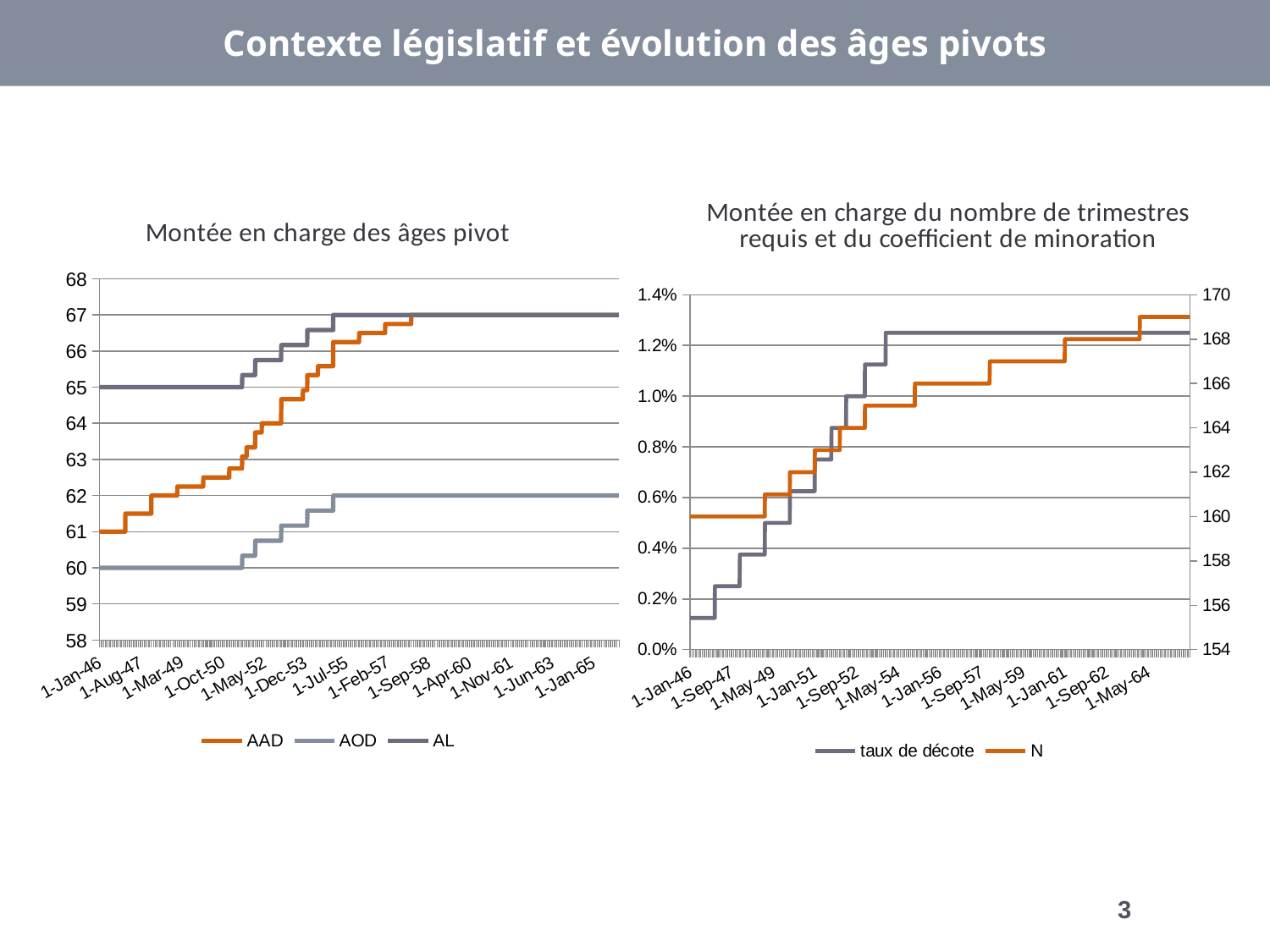
In the chart titled "Montée en charge des âges pivot", what is the value of AAD at 1-Jan-46? 61 In the chart titled "Montée en charge des âges pivot", how many series does the legend list? 3 In the chart titled "Montée en charge des âges pivot", what value does AOD reach at 1-Jan-65? 62 In the chart titled "Montée en charge du nombre de trimestres requis et du coefficient de minoration", is the value of taux de décote at 1-Jan-46 greater or less than 0.2%? less In the chart titled "Montée en charge des âges pivot", what is the value of AL at 1-Jan-46? 65 In the chart titled "Montée en charge des âges pivot", what kind of chart is shown? line chart In the chart titled "Montée en charge des âges pivot", what is the value of AOD at 1-Jan-46? 60 In the chart titled "Montée en charge du nombre de trimestres requis et du coefficient de minoration", what is the value of N at 1-Jan-46? 160 In the chart titled "Montée en charge du nombre de trimestres requis et du coefficient de minoration", how many series does the legend list? 2 In the chart titled "Montée en charge des âges pivot", what are the three series named in the legend? AAD, AOD, AL In the chart titled "Montée en charge des âges pivot", do the AAD values rise or fall over time? rise In the chart titled "Montée en charge des âges pivot", which series is lowest at 1-Jan-65: AL or AOD? AOD